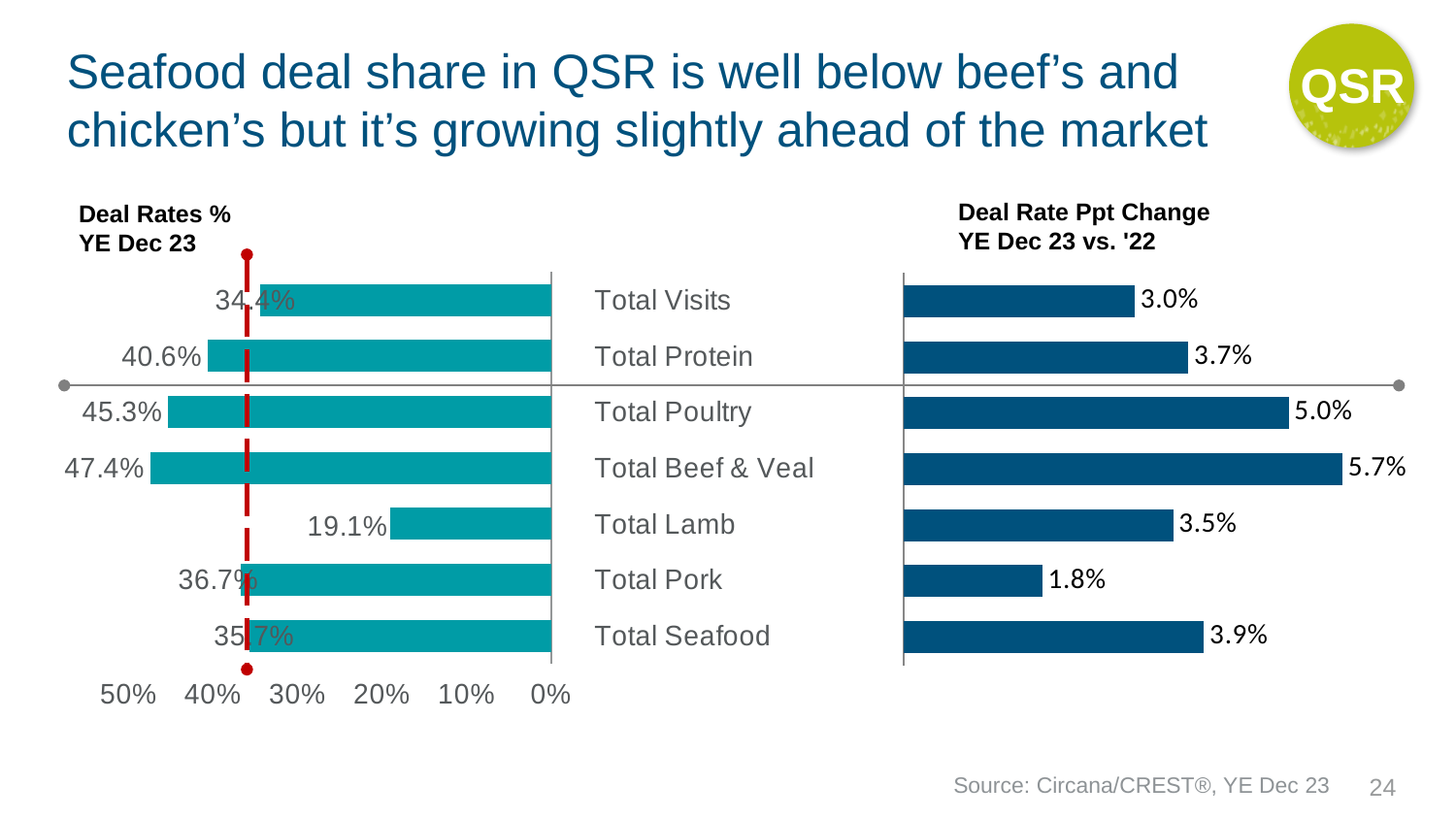
In the Deal Rates % YE Dec 23 chart, what is the value for Total Lamb? 19.1% What type of chart is the Deal Rate Ppt Change YE Dec 23 vs. '22 chart? Bar chart In the Deal Rate Ppt Change YE Dec 23 vs. '22 chart, what is the value for Total Pork? 1.8% In the Deal Rates % YE Dec 23 chart, what is the difference between Total Poultry and Total Protein? 4.7 percentage points In the Deal Rates % YE Dec 23 chart, what is the value for Total Beef & Veal? 47.4% In the Deal Rate Ppt Change YE Dec 23 vs. '22 chart, which is larger, Total Seafood or Total Visits? Total Seafood In the Deal Rates % YE Dec 23 chart, which category has the lowest deal rate? Total Lamb How many categories are shown in the Deal Rates % YE Dec 23 chart? 7 In the Deal Rates % YE Dec 23 chart, which category has the highest deal rate? Total Beef & Veal In the Deal Rate Ppt Change YE Dec 23 vs. '22 chart, what is the value for Total Seafood? 3.9% In the Deal Rate Ppt Change YE Dec 23 vs. '22 chart, which category has the smallest change? Total Pork In the Deal Rate Ppt Change YE Dec 23 vs. '22 chart, which category has the largest change? Total Beef & Veal